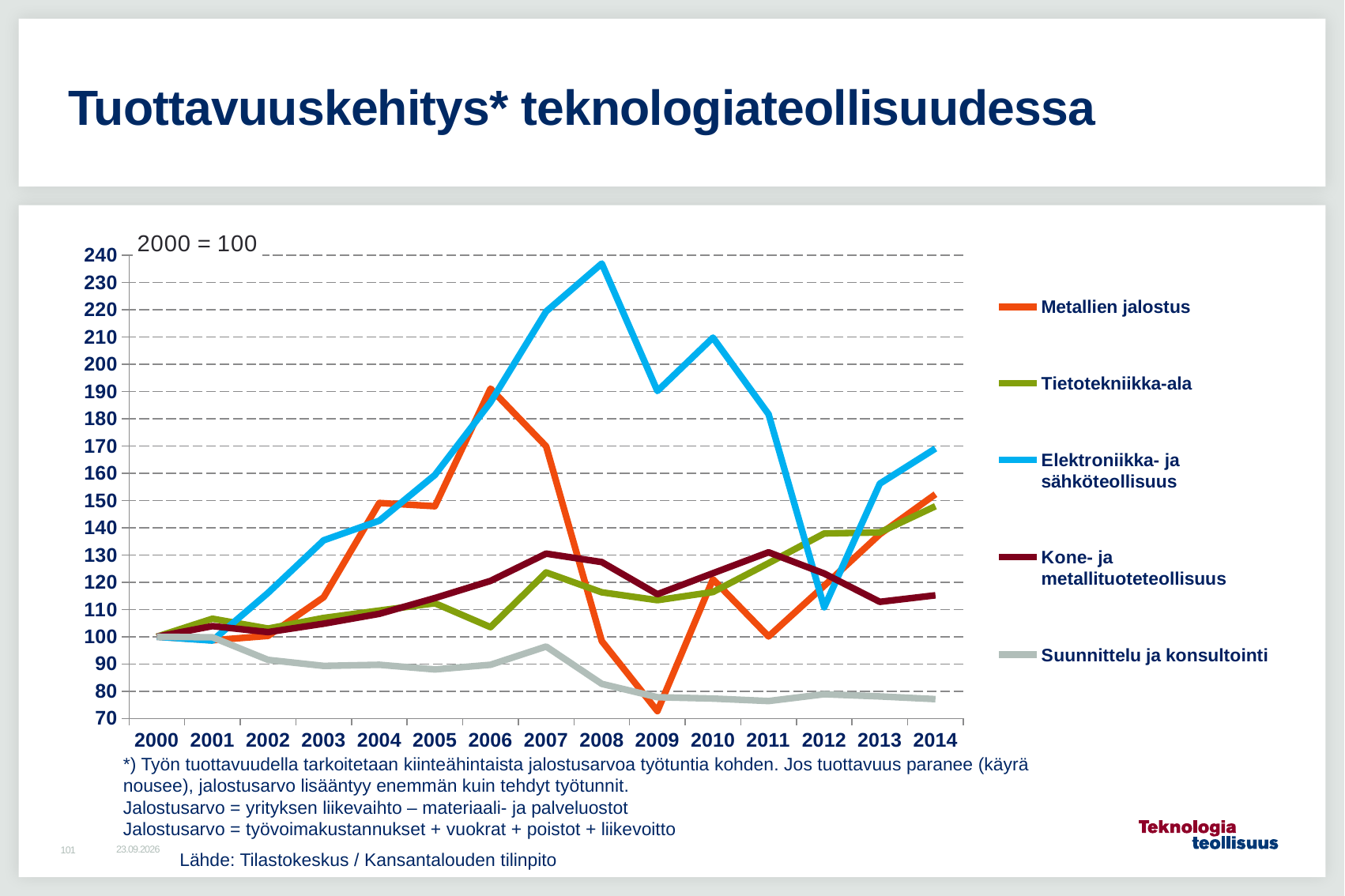
What type of chart is shown on the slide? line chart Is the value for Metallien jalostus in 2009 greater or less than 80? less Is the value for Suunnittelu ja konsultointi in 2014 greater or less than 90? less What is the index value of every series in the base year 2000? 100 Is the value for Kone- ja metallituoteteollisuus in 2011 greater or less than 120? greater How many series does the legend list? 5 Which series has the lowest value in 2014? Suunnittelu ja konsultointi In 2012, which is larger: Tietotekniikka-ala or Elektroniikka- ja sähköteollisuus? Tietotekniikka-ala Which series reaches the highest value anywhere on the chart? Elektroniikka- ja sähköteollisuus Does the Suunnittelu ja konsultointi line rise or fall from 2000 to 2014? fall How many years are shown on the x axis? 15